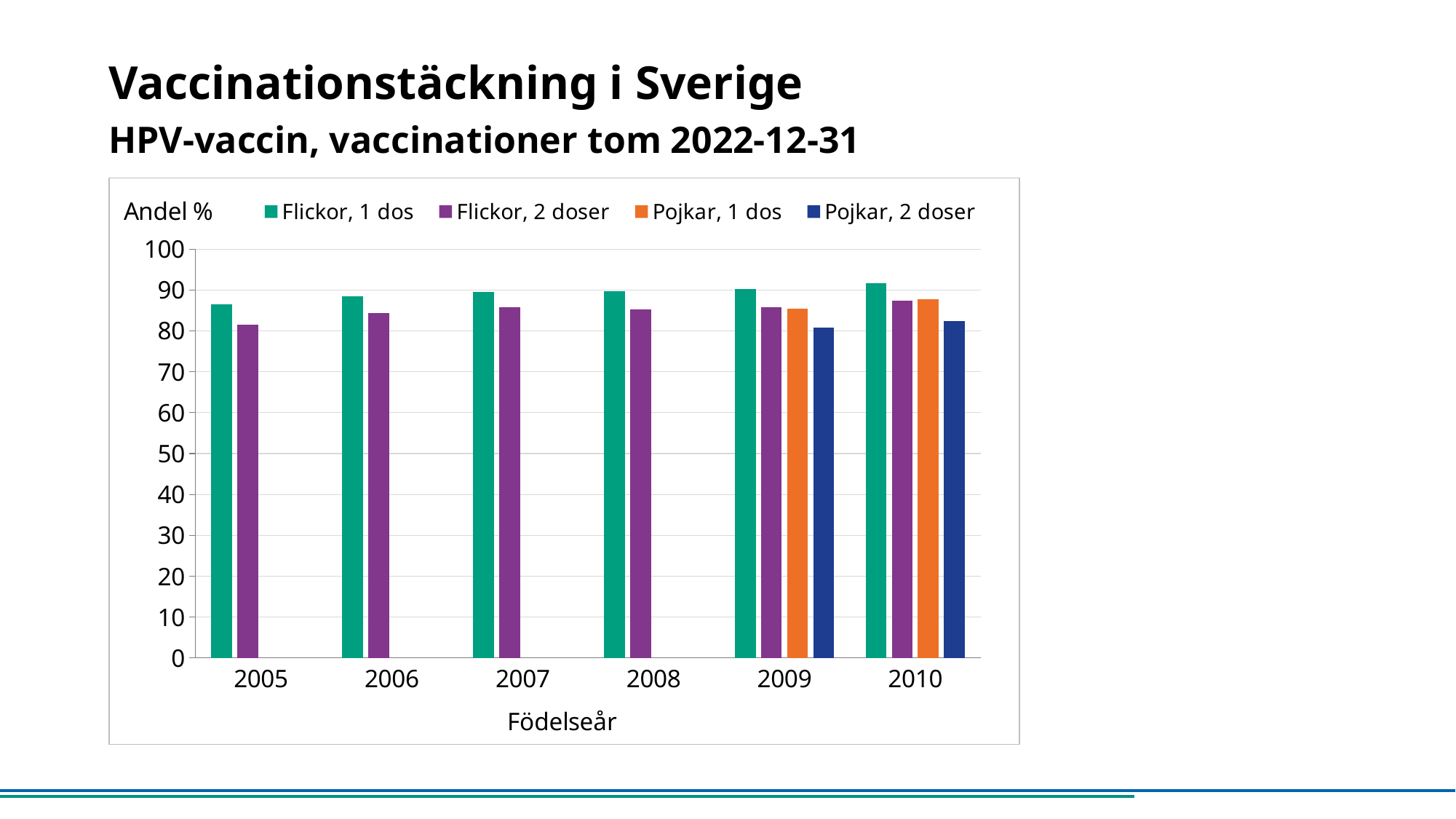
Which birth year has the lowest value for Flickor, 1 dos? 2005 How many birth years (Födelseår) are shown on the x axis? 6 What is the label of the x axis? Födelseår What kind of chart is shown on the slide? bar chart Which birth year has the highest value for Flickor, 1 dos? 2010 Is the value for Flickor, 1 dos in 2005 greater or less than 90? less Which series is shown in orange? Pojkar, 1 dos Does the value for Flickor, 1 dos rise or fall from 2005 to 2010? rise Is the value for Flickor, 2 doser in 2006 greater or less than 90? less For birth year 2005, which is larger: Flickor, 1 dos or Flickor, 2 doser? Flickor, 1 dos Is the value for Flickor, 1 dos in 2010 greater or less than 90? greater How many series does the legend list? 4